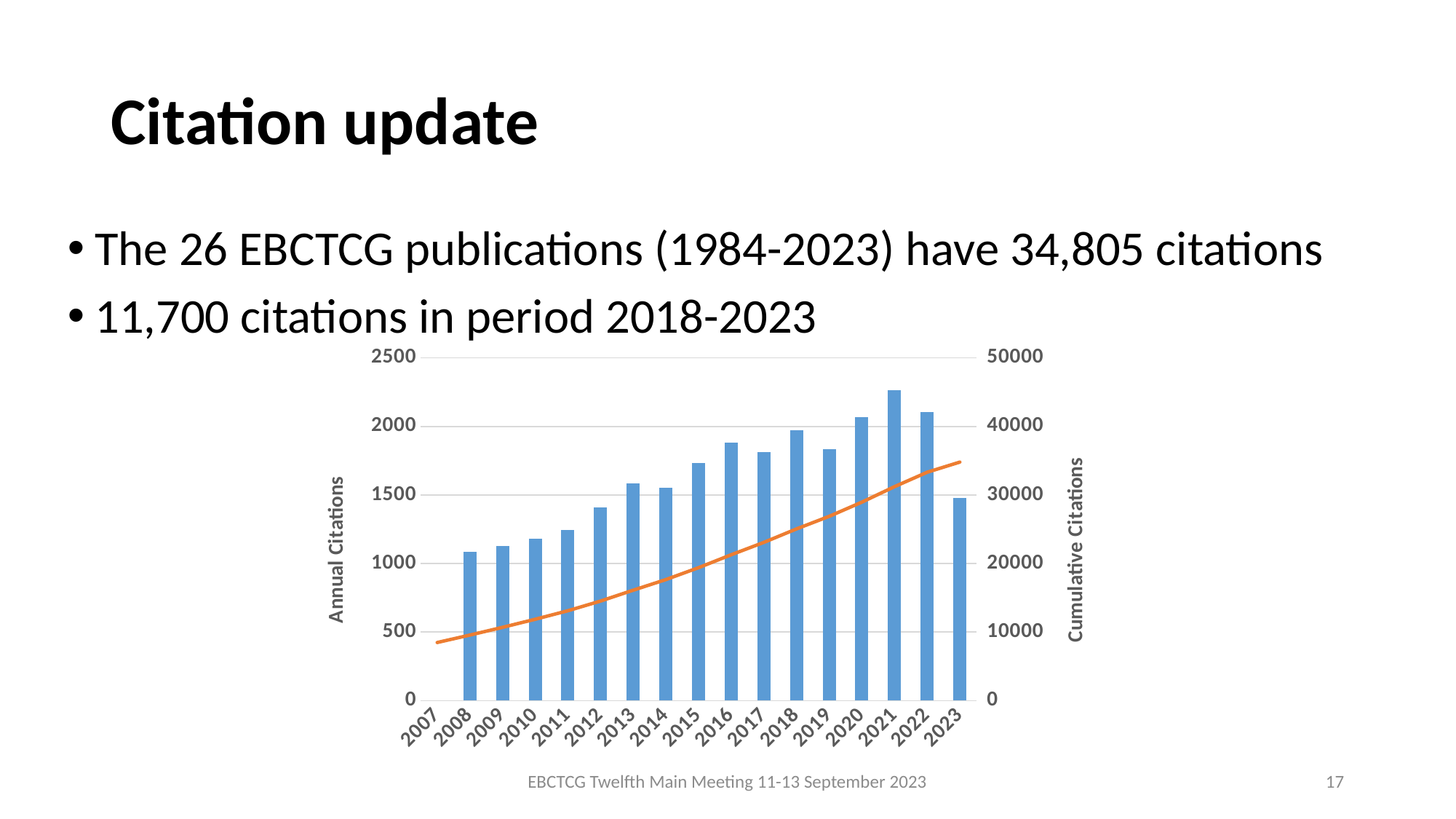
Which year has more annual citations, 2021 or 2022? 2021 What is the label of the right-hand vertical axis? Cumulative Citations Is the annual citations value for 2016 greater or less than 1500? greater How many years have a bar for annual citations? 16 Does the cumulative citations line rise or fall from 2007 to 2023? Rises What kind of chart is shown on the slide? A bar chart with a line overlay Which year has more annual citations, 2019 or 2020? 2020 Is the cumulative citations value at 2023 greater or less than 30000? greater Which year has the tallest bar for annual citations? 2021 Which year has the shortest bar for annual citations? 2008 Is the annual citations value for 2012 greater or less than 1500? less